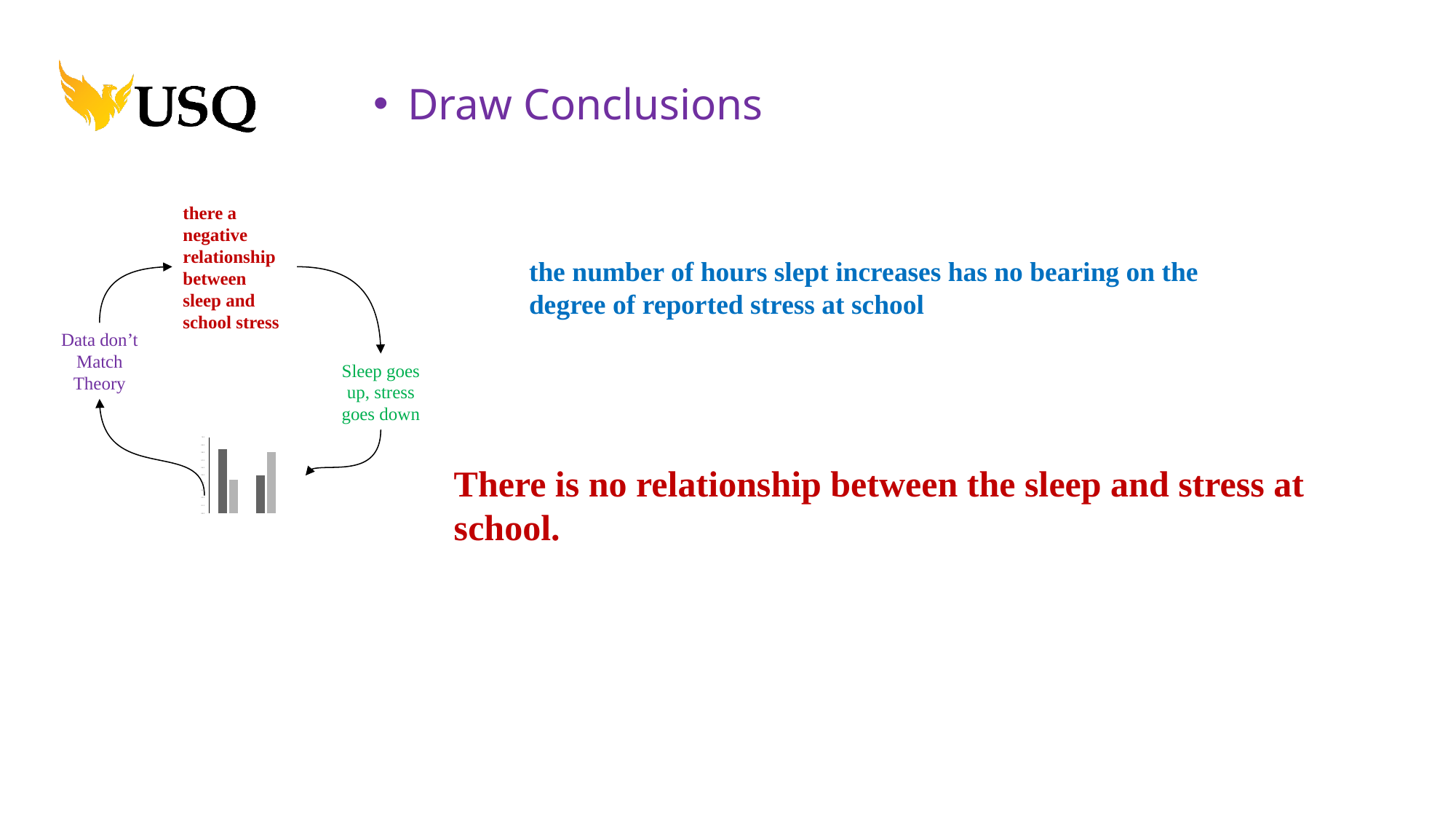
In the small bar chart on the left of the slide, is the leftmost bar taller or shorter than the bar immediately to its right? taller What kind of chart is shown in the small diagram on the left of the slide? bar chart How many different shades are used for the bars in the small bar chart on the left of the slide? 2 Does the small bar chart on the left of the slide show a chart title? No How many bars does the small bar chart on the left of the slide contain? 4 In the small bar chart on the left of the slide, which bar is the shortest: the first, second, third or fourth from the left? second In the small bar chart on the left of the slide, which bar is the tallest: the first, second, third or fourth from the left? first